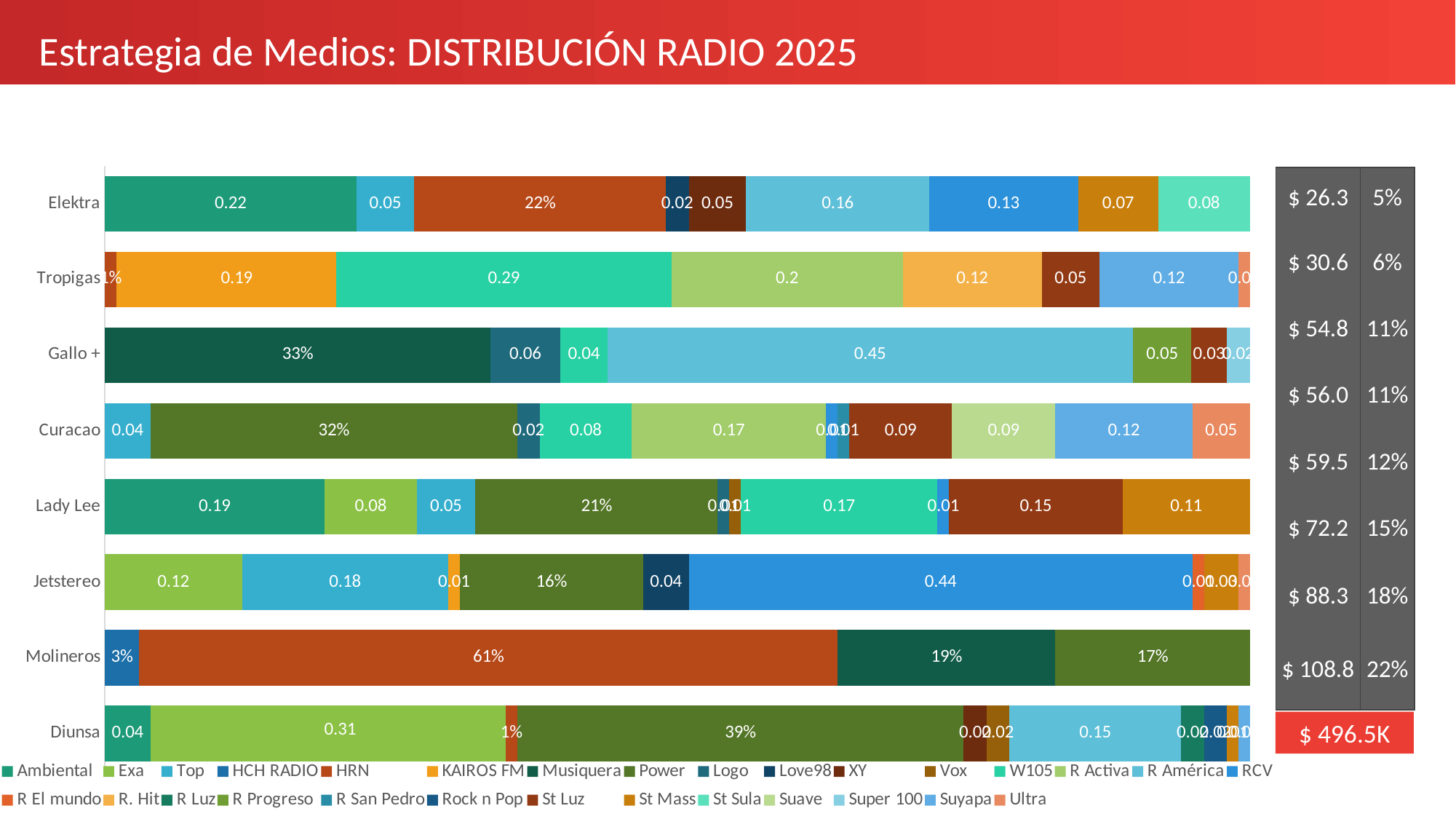
What kind of chart is shown on the slide? stacked bar chart What is the title of the slide containing the chart? Estrategia de Medios: DISTRIBUCIÓN RADIO 2025 What is the value of the largest labeled segment in the Jetstereo bar? 0.44 What is the difference between the 61% segment and the 19% segment in the Molineros bar? 42% What is the value of the largest labeled segment in the Gallo + bar? 0.45 What is the value of the largest labeled segment in the Diunsa bar? 39% What is the value of the HRN (orange-red) segment in the Molineros bar? 61% What is the largest labeled segment value in the Molineros bar? 61% Which is larger: the largest segment in the Molineros bar (61%) or the largest segment in the Diunsa bar (39%)? Molineros What is the value of the first (leftmost) segment in the Elektra bar? 0.22 How many categories (retailers) are plotted on the vertical axis of the chart? 8 Which category is listed at the top of the chart's vertical axis? Elektra